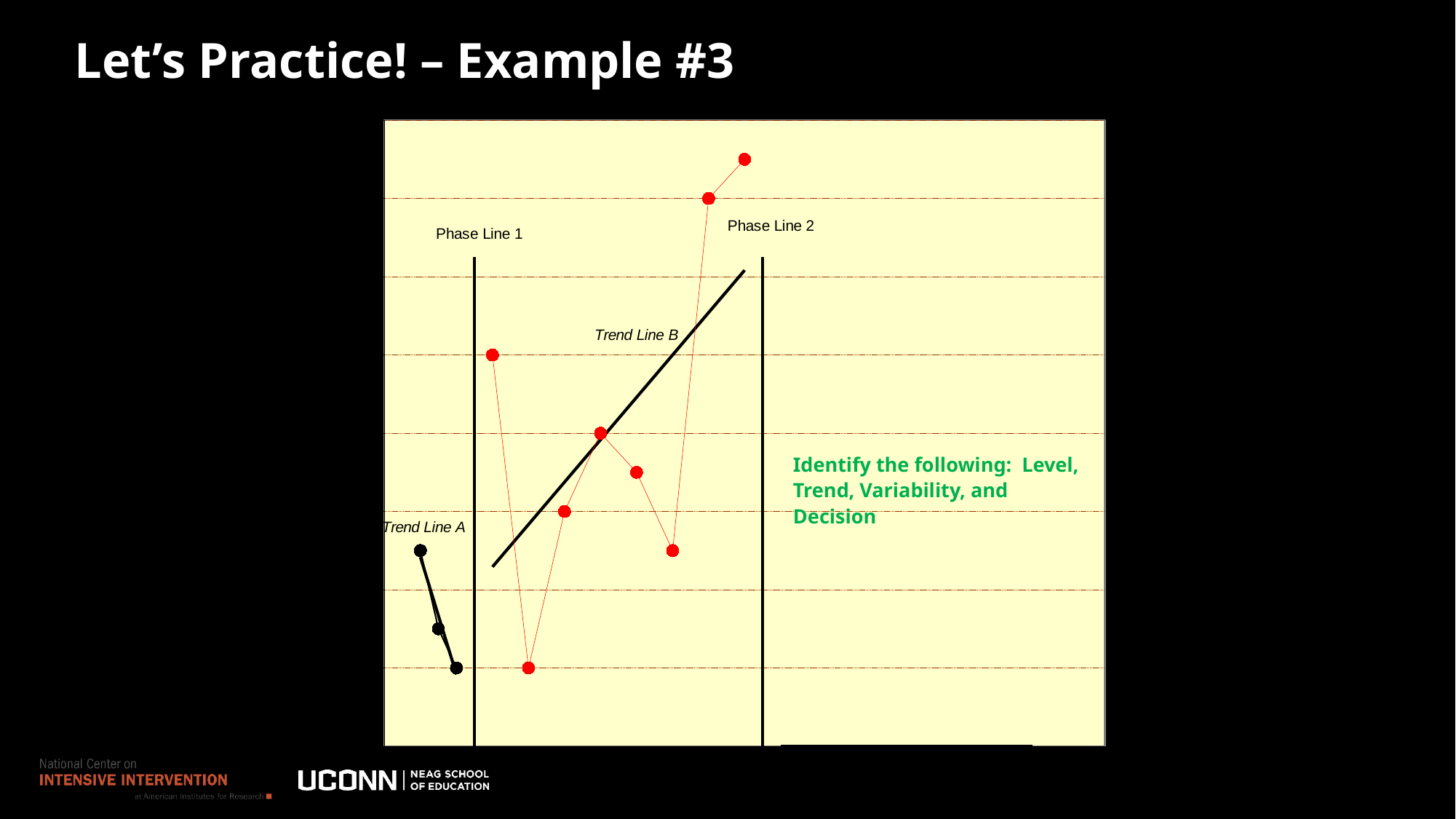
Which red data point between the phase lines is the highest: the first one or the last one? the last one How many red data points are plotted between Phase Line 1 and Phase Line 2? 8 What colour are the data points plotted between Phase Line 1 and Phase Line 2? red How many black data points are plotted to the left of Phase Line 1? 3 Is the highest red data point the leftmost or the rightmost red point? the rightmost Which red data point between the phase lines is the lowest: the first one or the second one? the second one What are the two vertical phase lines on the chart labelled? Phase Line 1 and Phase Line 2 Does Trend Line A rise or fall from left to right? fall Do the black data points before Phase Line 1 rise or fall from left to right? fall Does Trend Line B rise or fall from left to right? rise What kind of chart is shown on the slide? line chart